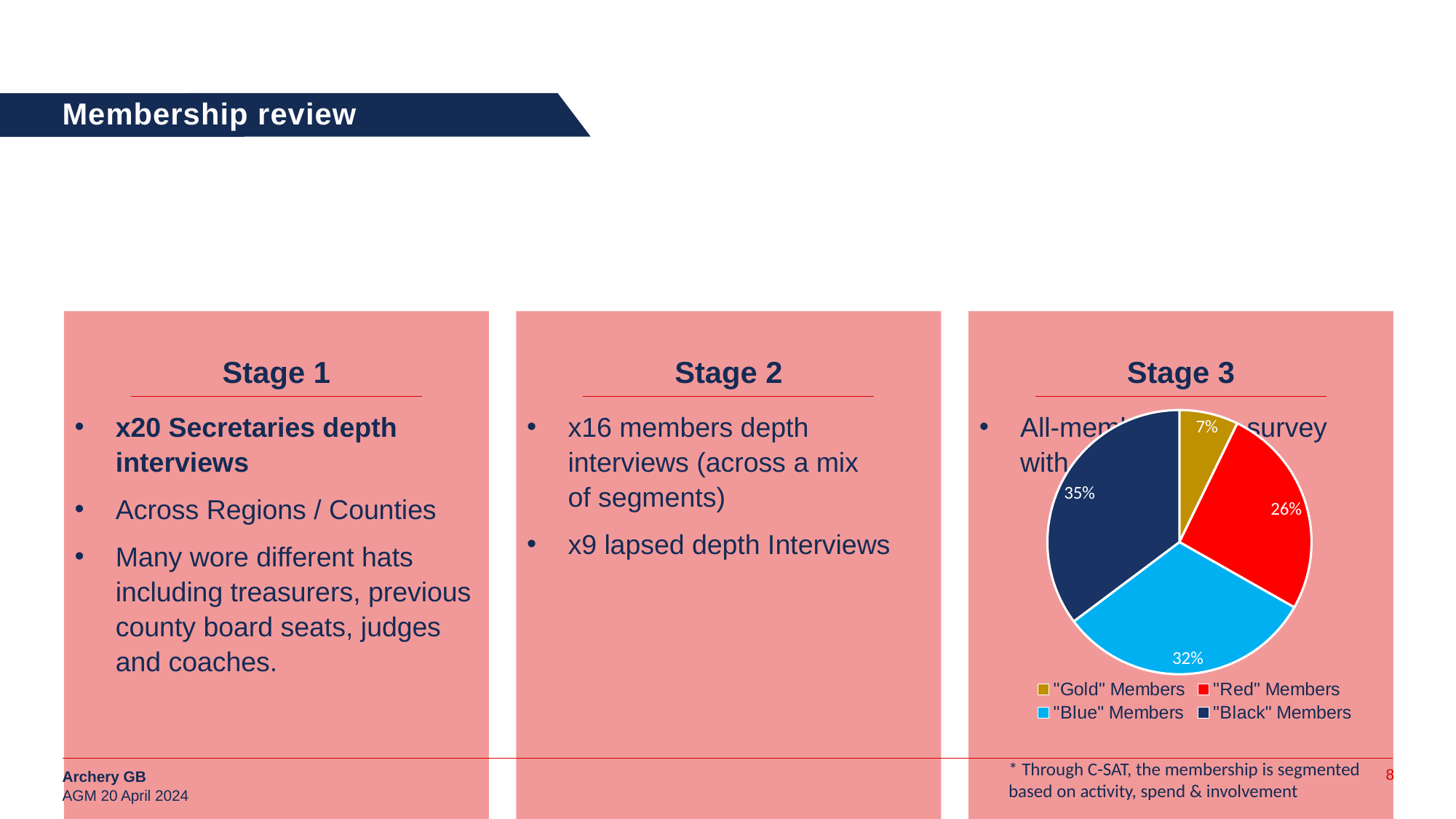
What is the difference in percentage points between "Black" Members and "Red" Members? 9 How many segments does the pie chart have? 4 How many entries does the pie chart legend list? 4 What percentage of the pie chart is "Black" Members? 35% What percentage of the pie chart is "Gold" Members? 7% What percentage of the pie chart is "Red" Members? 26% What percentage of the pie chart is "Blue" Members? 32% What colour represents "Gold" Members in the pie chart? gold Which member segment has the largest share of the pie chart? "Black" Members Which is larger in the pie chart, "Blue" Members or "Red" Members? "Blue" Members What kind of chart is shown in the Stage 3 panel? pie chart Which member segment has the smallest share of the pie chart? "Gold" Members